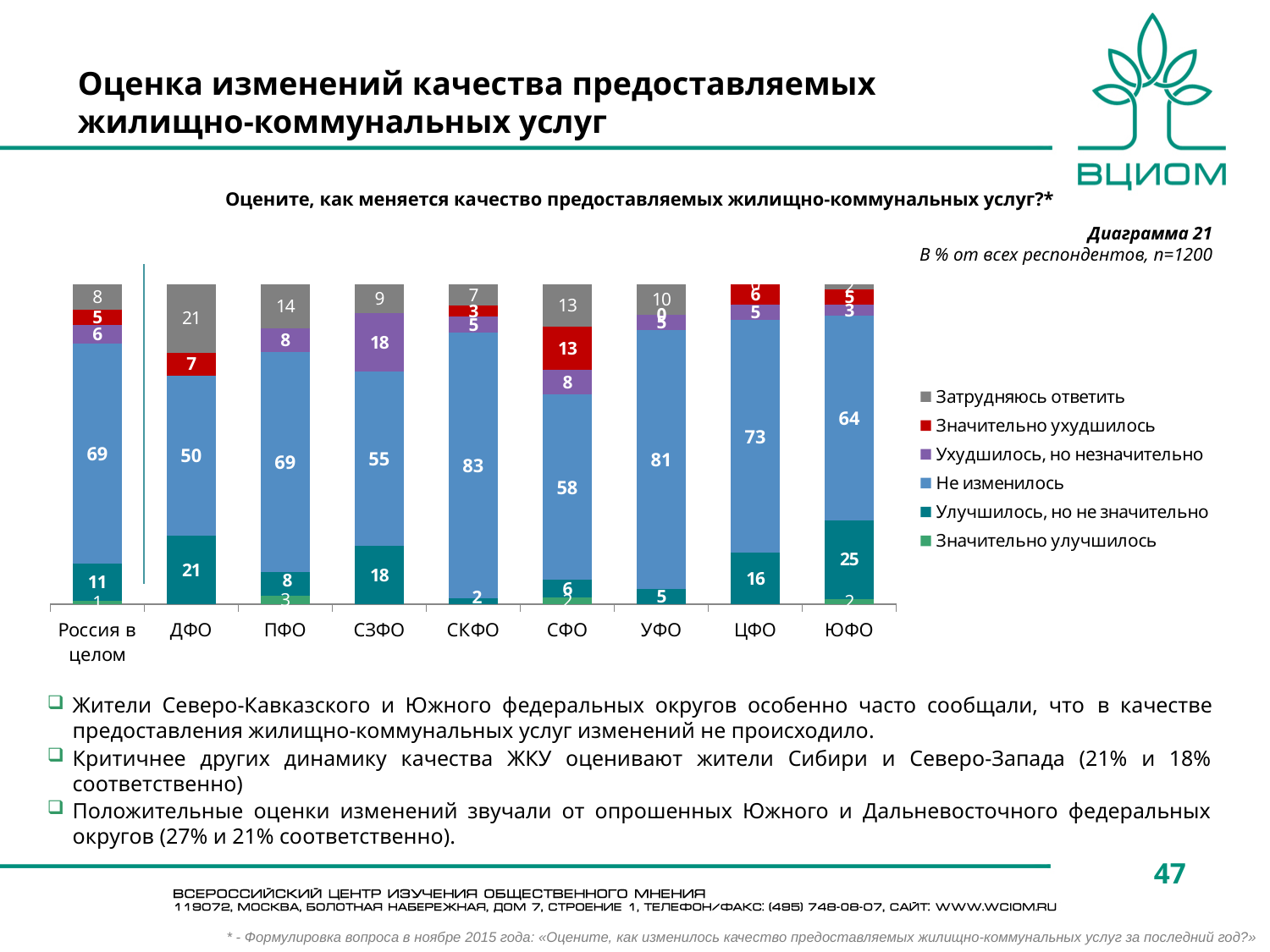
What kind of chart is shown on the slide? stacked bar chart Which is larger: "Улучшилось, но не значительно" for ЦФО or for СЗФО? СЗФО How many categories (regions) are shown along the x axis? 9 Which region has the highest value for "Не изменилось"? СКФО Which region has the lowest value for "Не изменилось"? ДФО How many series does the legend list? 6 What is the value of "Значительно ухудшилось" for СФО? 13 What is the difference between the "Не изменилось" values for СКФО and ДФО? 33 What is the value of "Затрудняюсь ответить" for ДФО? 21 What is the value of "Ухудшилось, но незначительно" for СЗФО? 18 What is the value of "Не изменилось" for СКФО? 83 What is the value of "Улучшилось, но не значительно" for ЮФО? 25